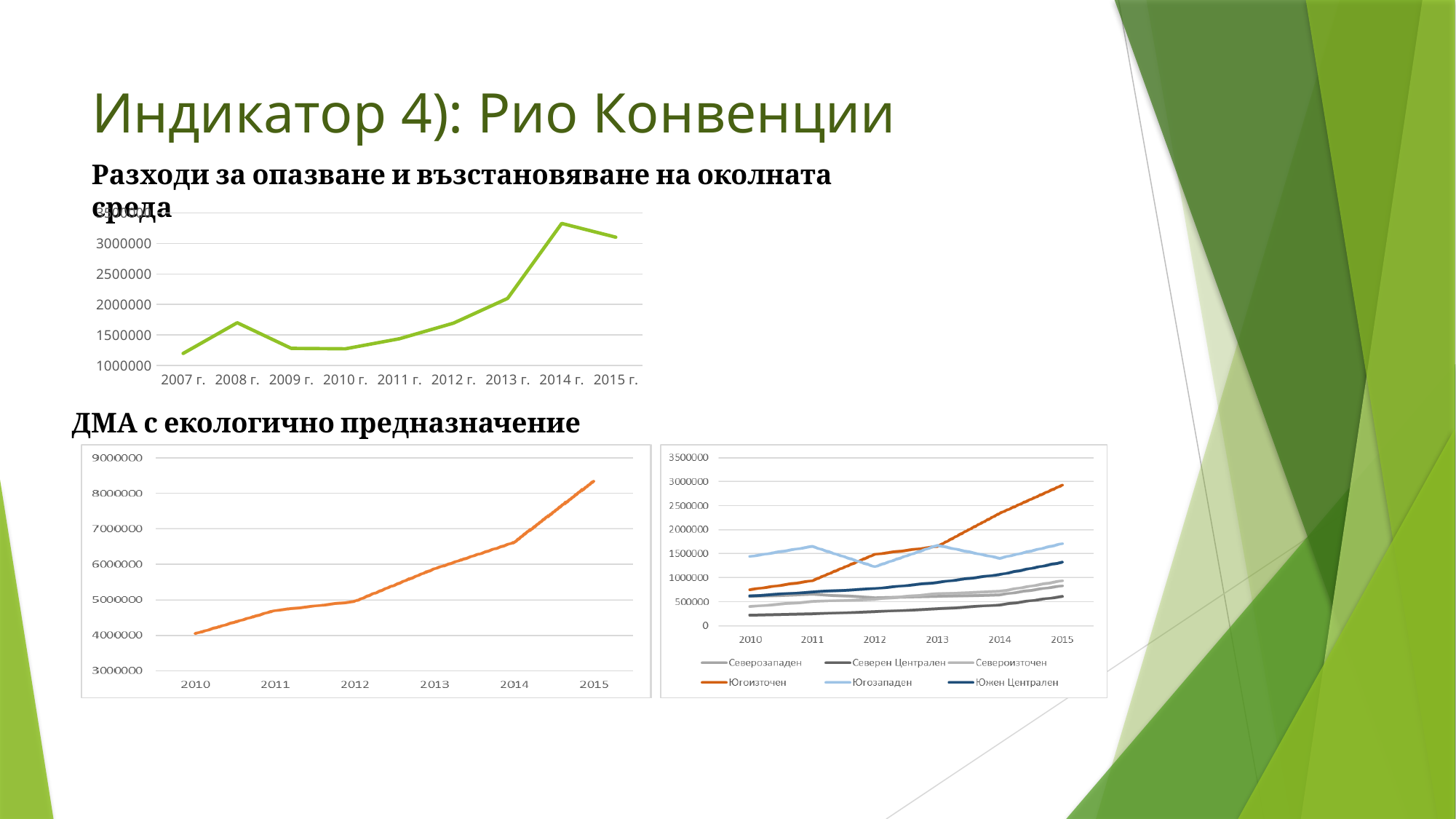
In the bottom-right chart, which series has the highest value in 2015? Югоизточен In the bottom-right chart, which series has the lowest value in 2010? Северен Централен How many series does the legend of the bottom-right chart list? 6 In the top chart (Разходи за опазване и възстановяване на околната среда), how many years are plotted on the x axis? 9 In the bottom-left chart (ДМА с екологично предназначение), is the value for 2015 greater or less than 8000000? greater In the top chart (Разходи за опазване и възстановяване на околната среда), is the value for 2007 г. greater or less than 1500000? less In the bottom-left chart (ДМА с екологично предназначение), is the value for 2010 greater or less than 5000000? less In the top chart (Разходи за опазване и възстановяване на околната среда), which is larger, the value for 2008 г. or the value for 2009 г.? 2008 г. In the bottom-left chart (ДМА с екологично предназначение), do the values generally rise or fall from 2010 to 2015? rise What type of chart is the top chart (Разходи за опазване и възстановяване на околната среда)? line chart In the top chart (Разходи за опазване и възстановяване на околната среда), which year has the highest value? 2014 г.